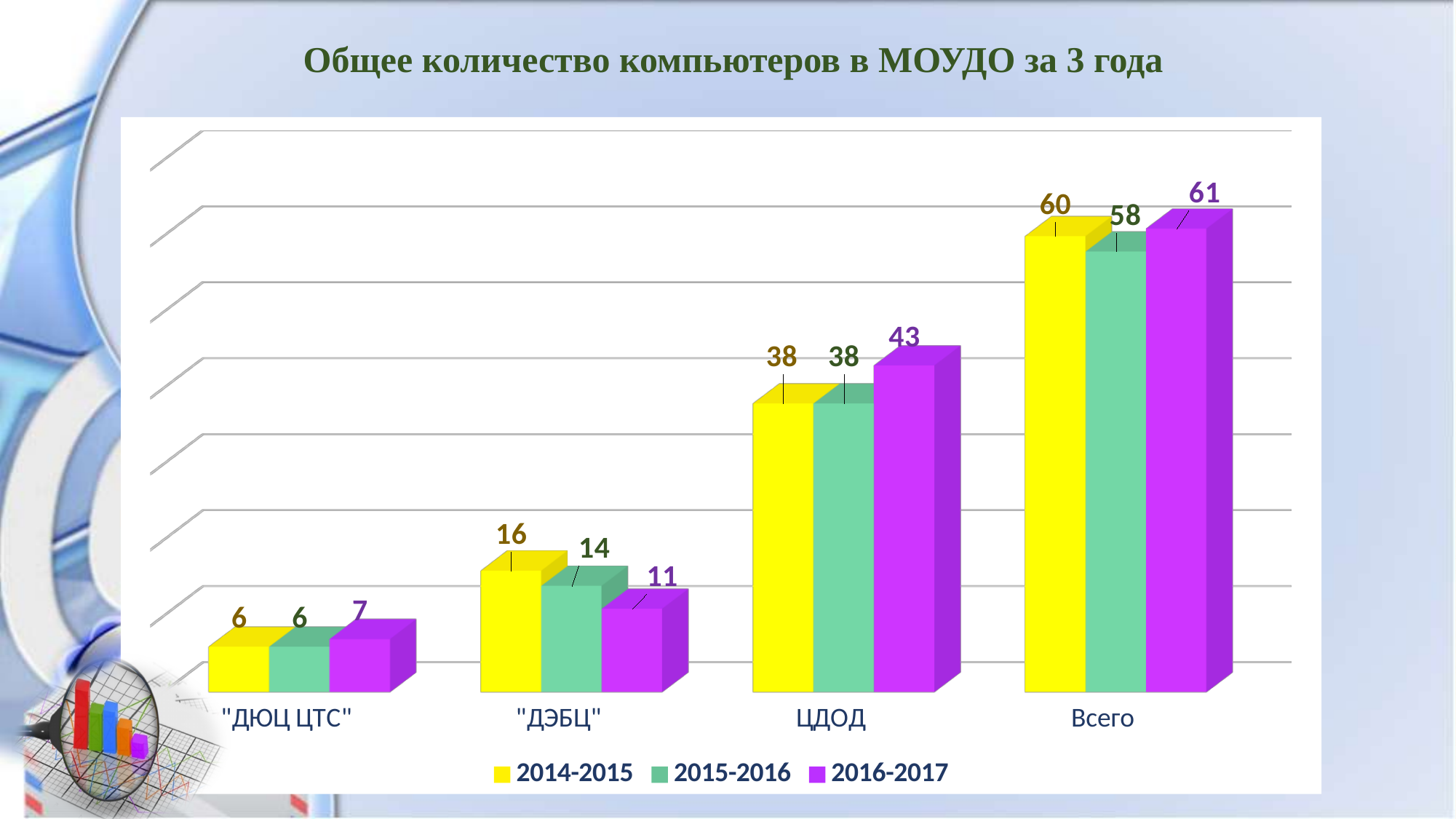
How many series does the legend list? 3 How many categories are shown on the x axis? 4 What is the value for "ДЮЦ ЦТС" in the 2016-2017 series? 7 What is the value for ЦДОД in the 2016-2017 series? 43 What is the difference between the 2014-2015 and 2016-2017 values for "ДЭБЦ"? 5 What is the value for Всего in the 2015-2016 series? 58 Which category has the lowest value in the 2014-2015 series? "ДЮЦ ЦТС" What is the value for "ДЭБЦ" in the 2014-2015 series? 16 Which is larger for ЦДОД: the 2015-2016 value or the 2016-2017 value? 2016-2017 What is the title of the chart? Общее количество компьютеров в МОУДО за 3 года What kind of chart is shown on the slide? Bar chart Which category has the highest value in the 2016-2017 series? Всего